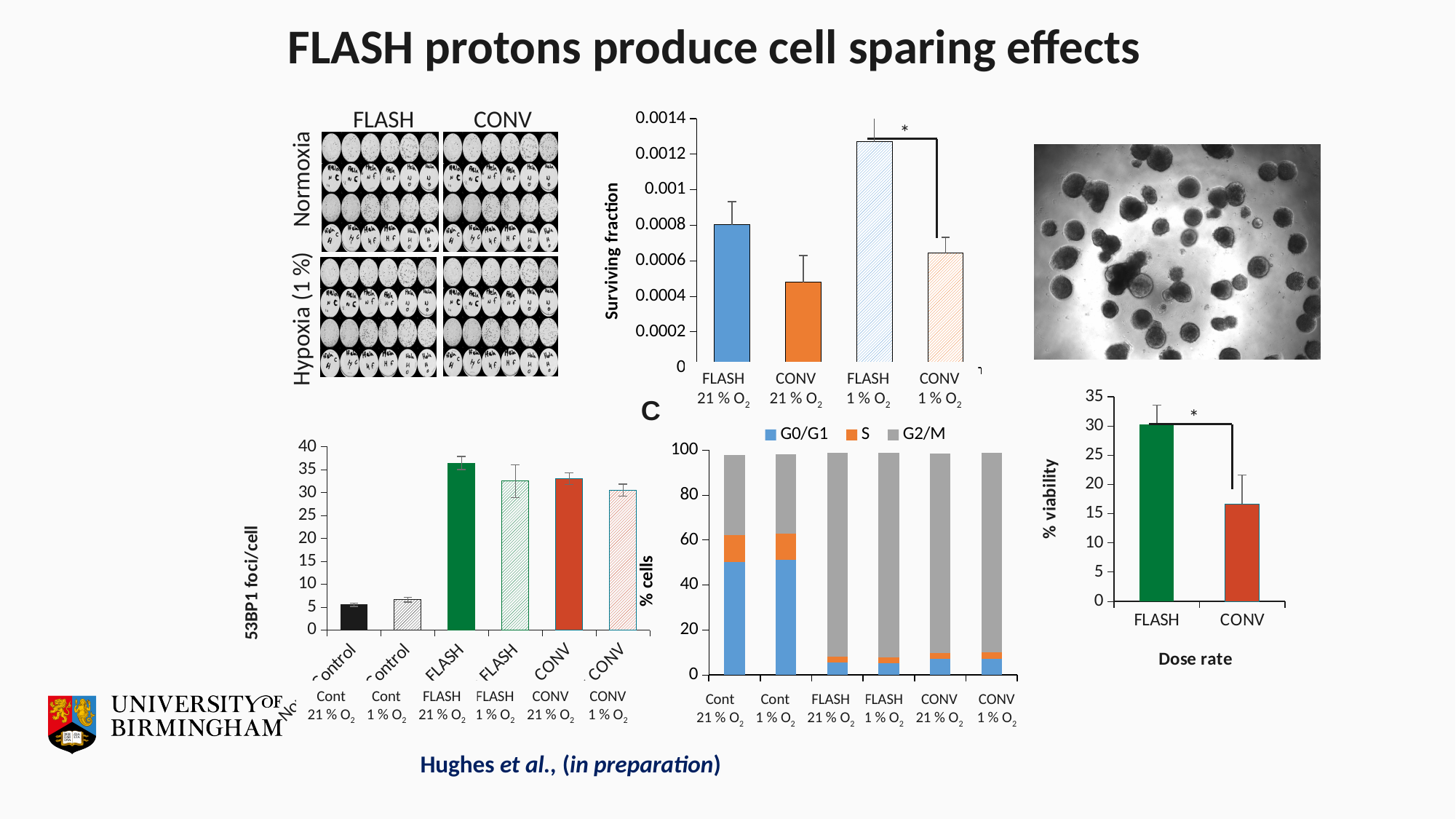
In the Surviving fraction chart, which category has the highest surviving fraction? FLASH 1 % O2 In the Surviving fraction chart, which category has the lowest surviving fraction? CONV 21 % O2 How many series does the legend of the % cells stacked bar chart list? 3 In the % viability chart, which is larger, FLASH or CONV? FLASH In the Surviving fraction chart, is the value for CONV 21 % O2 greater or less than 0.0006? less In the 53BP1 foci/cell chart, is the value for Cont 21 % O2 greater or less than 10? less What kind of chart is the % viability chart? bar chart In the % cells stacked bar chart, is the G0/G1 value for Cont 21 % O2 greater or less than 40? greater How many bars are plotted in the Surviving fraction chart? 4 In the 53BP1 foci/cell chart, which is larger, FLASH 21 % O2 or Cont 1 % O2? FLASH 21 % O2 In the 53BP1 foci/cell chart, which category has the highest value? FLASH 21 % O2